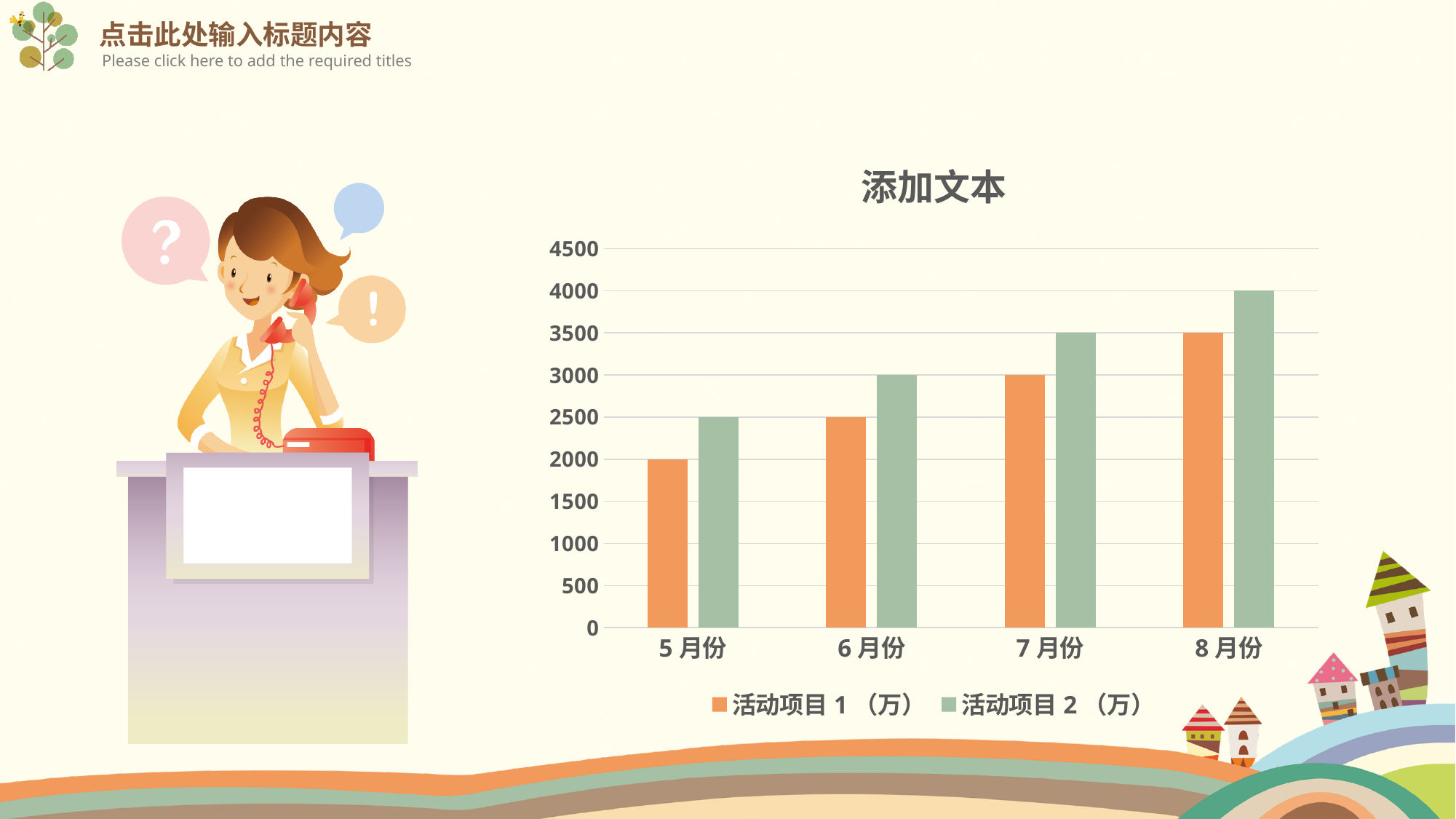
What kind of chart is shown on the slide? bar chart How many series does the chart legend list? 2 What is the difference between 活动项目 2 （万） and 活动项目 1 （万） for 7 月份? 500 Which month has the highest value for 活动项目 1 （万）? 8 月份 What is the value of 活动项目 2 （万） for 6 月份? 3000 What is the title of the chart? 添加文本 What is the value of 活动项目 1 （万） for 5 月份? 2000 Do the values of 活动项目 1 （万） rise or fall from 5 月份 to 8 月份? rise How many categories are shown on the x axis of the chart? 4 Which is larger for 6 月份: 活动项目 1 （万） or 活动项目 2 （万）? 活动项目 2 （万） What is the value of 活动项目 2 （万） for 8 月份? 4000 Which month has the lowest value for 活动项目 2 （万）? 5 月份